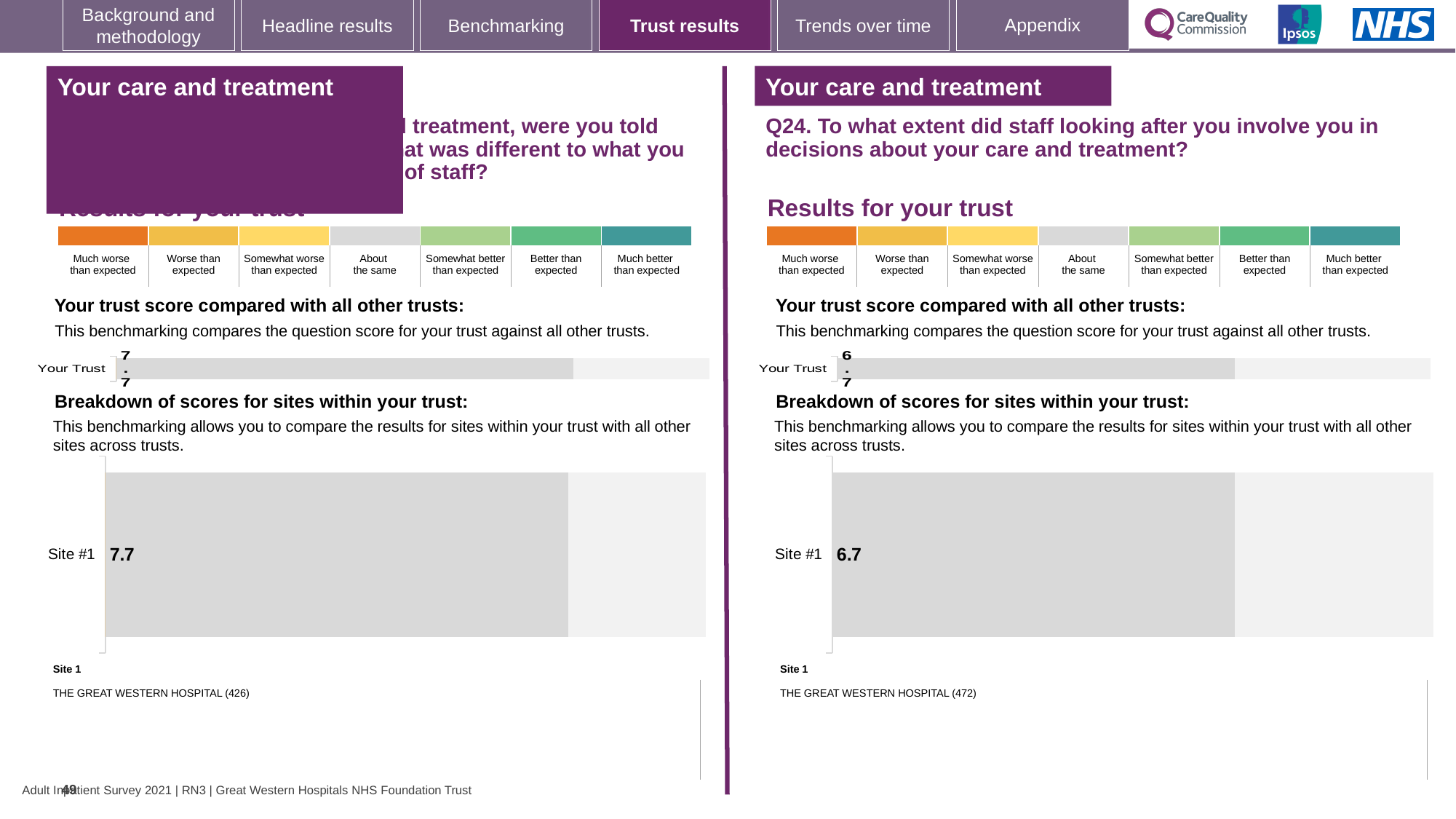
What kind of chart is used to show the Site #1 score on the right-hand panel (Q24)? Bar chart On the left-hand panel, what is the score shown for Your Trust? 7.7 What is the difference between the Site #1 score on the left-hand panel and the Site #1 score on the right-hand panel (Q24)? 1.0 On the left-hand panel, what is the score shown for Site #1? 7.7 Which is larger: the Site #1 score on the left-hand panel or the Site #1 score on the right-hand panel (Q24)? Left-hand panel (7.7) On the left-hand panel, which hospital is listed as Site 1? THE GREAT WESTERN HOSPITAL (426) How many sites are shown in the breakdown of scores on the left-hand panel? 1 On the right-hand panel (Q24), which hospital is listed as Site 1? THE GREAT WESTERN HOSPITAL (472) On the right-hand panel (Q24), what is the score shown for Your Trust? 6.7 How many sites are shown in the breakdown of scores on the right-hand panel (Q24)? 1 On the right-hand panel (Q24), what is the score shown for Site #1? 6.7 What is the difference between the Your Trust score on the left-hand panel and the Your Trust score on the right-hand panel (Q24)? 1.0